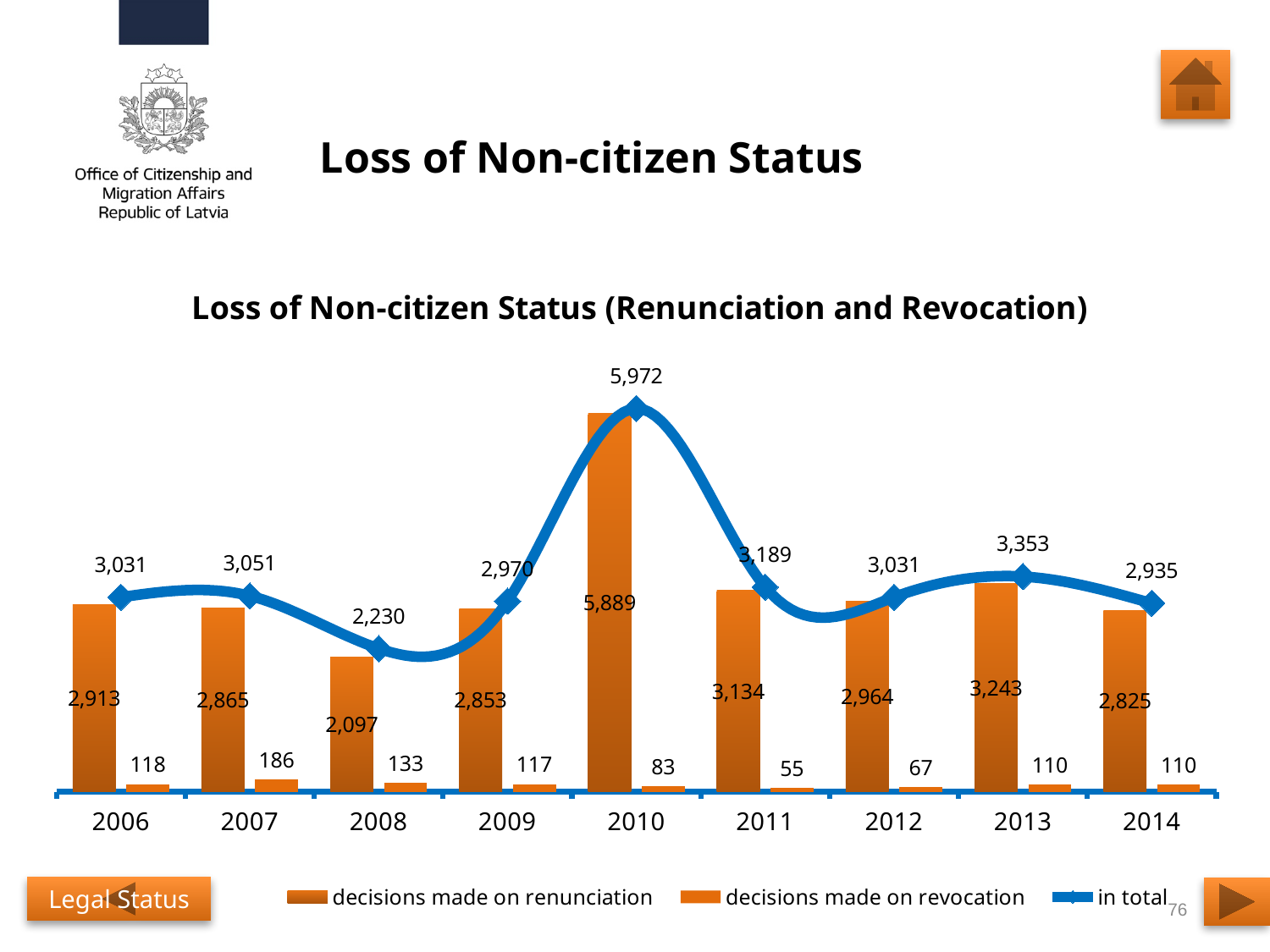
Which year has the highest 'in total' value? 2010 How many series does the legend list? 3 How many years are shown on the x axis? 9 Which year has the lowest value for 'decisions made on renunciation'? 2008 What kind of chart is this? Combined bar and line chart What is the difference between the 'in total' values for 2010 and 2009? 3,002 What is the title of the chart? Loss of Non-citizen Status (Renunciation and Revocation) Which year has the lowest value for 'decisions made on revocation'? 2011 Which is larger: 'decisions made on renunciation' in 2011 or in 2012? 2011 What is the 'in total' value for 2013? 3,353 What is the value of 'decisions made on revocation' for 2007? 186 What is the value of 'decisions made on renunciation' for 2010? 5,889